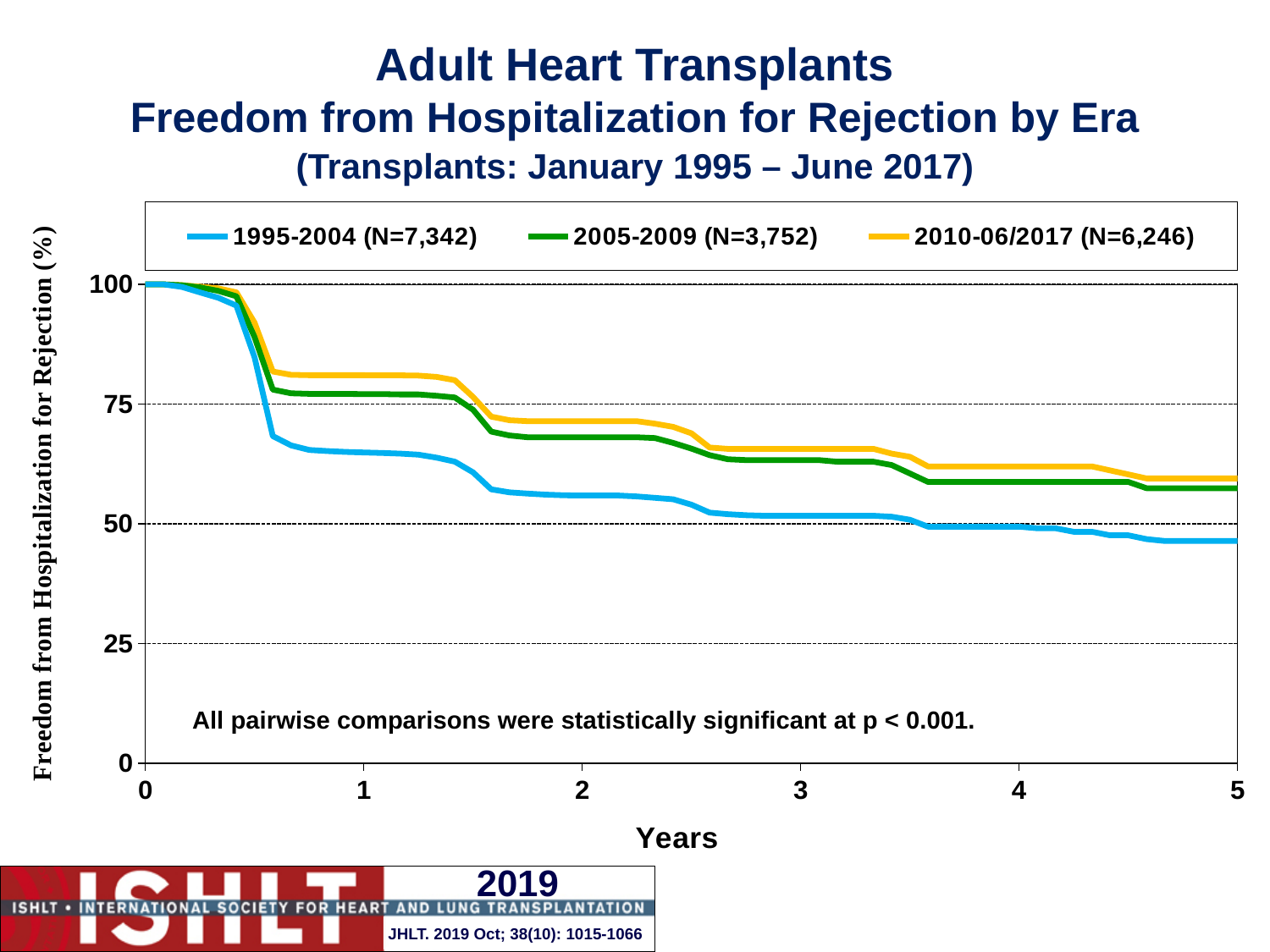
Is the value for the 1995-2004 series at year 1 greater or less than 75? less How many series does the legend list? 3 Is the value for the 2010-06/2017 series at year 5 greater or less than 50? greater Is the value for the 1995-2004 series at year 5 greater or less than 50? less According to the legend, what is the N for the 1995-2004 era? 7,342 What is the label of the x axis? Years What is the freedom from hospitalization for rejection for the 2005-2009 series at year 0? 100 Do the values for the 1995-2004 series rise or fall as years increase? fall Which era has the lowest freedom from hospitalization for rejection at year 5? 1995-2004 What kind of chart is shown on the slide? line chart